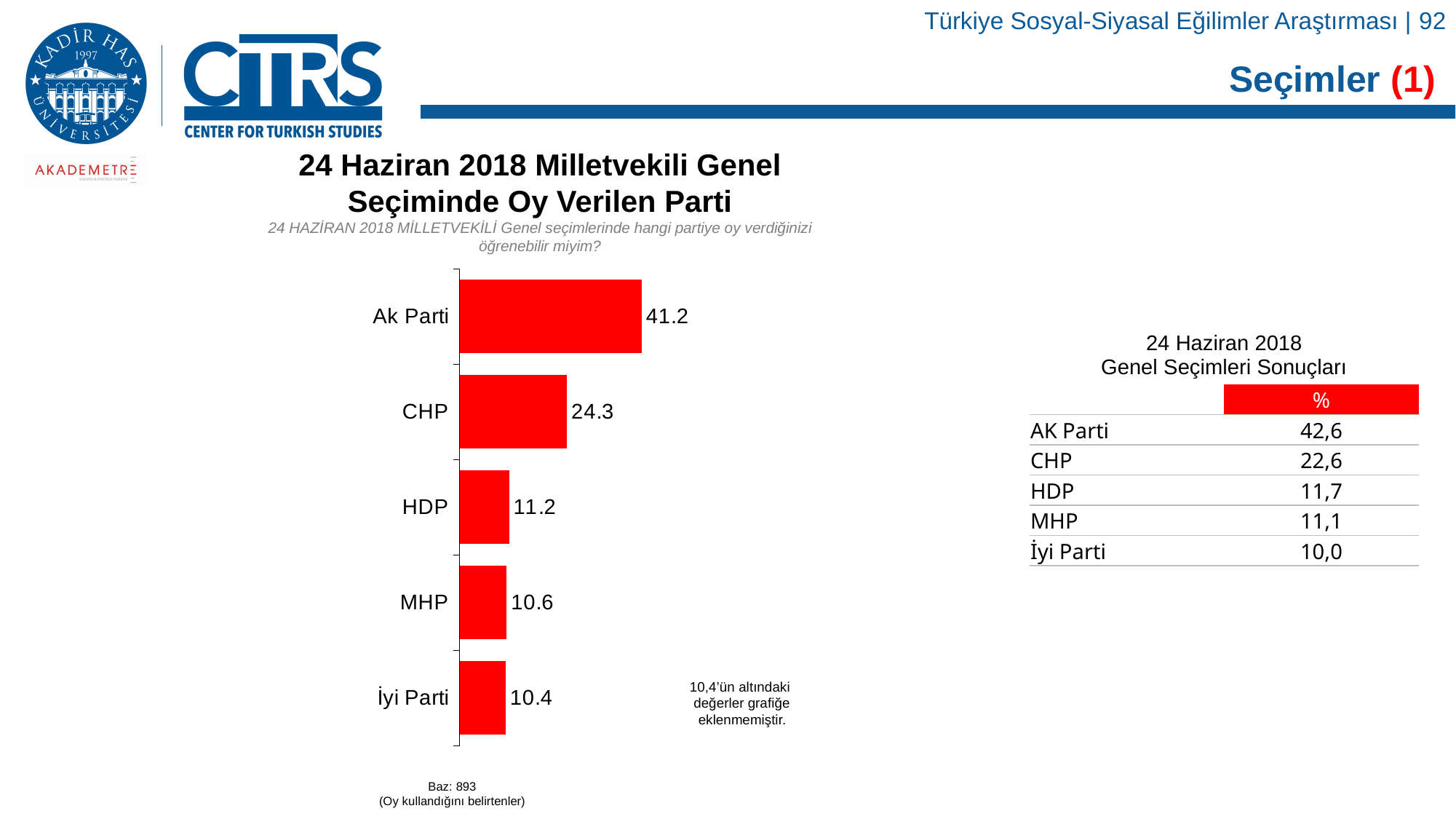
Which party has the highest value in the bar chart? Ak Parti How many parties are shown in the bar chart? 5 Which has a larger value in the bar chart, CHP or HDP? CHP What is the difference between the values for HDP and MHP in the bar chart? 0.6 What is the value for HDP in the bar chart? 11.2 What is the value for Ak Parti in the bar chart? 41.2 Which party has the lowest value in the bar chart? İyi Parti What kind of chart is shown on the slide? Bar chart What is the value for CHP in the bar chart? 24.3 What is the value for MHP in the bar chart? 10.6 What is the value for İyi Parti in the bar chart? 10.4 What is the difference between the values for Ak Parti and CHP in the bar chart? 16.9